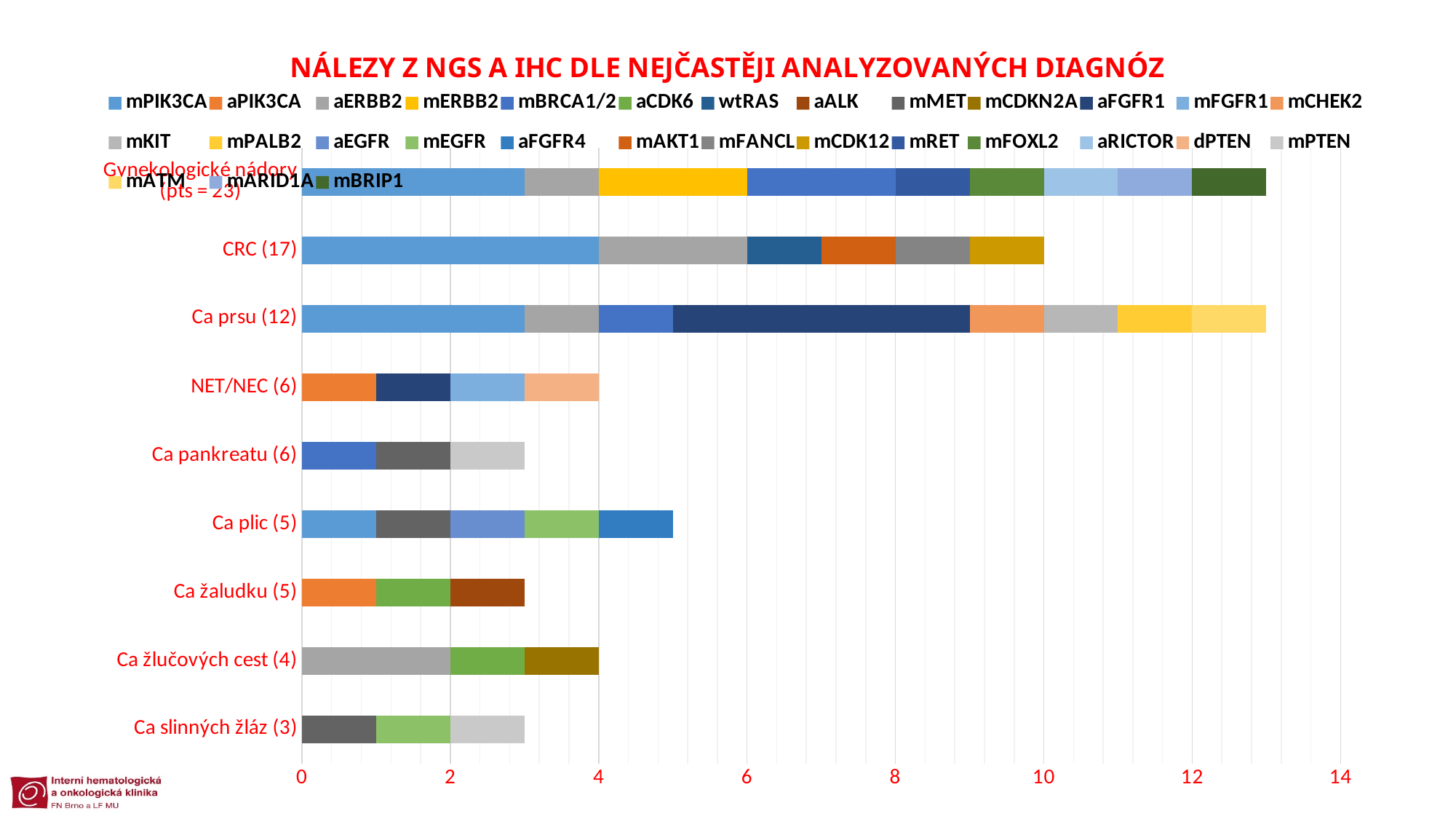
Is the total bar length for Ca plic (5) greater or less than 4? greater What is the title of the chart? NÁLEZY Z NGS A IHC DLE NEJČASTĚJI ANALYZOVANÝCH DIAGNÓZ What is the total length of the stacked bar for CRC (17)? 10 How many diagnosis categories are plotted on the chart? 9 What is the total length of the stacked bar for NET/NEC (6)? 4 How many series does the legend list? 29 Is the total bar length for Gynekologické nádory (pts = 23) greater or less than 12? greater Which has the longer total bar, CRC (17) or Ca plic (5)? CRC (17) What kind of chart is shown on the slide? Stacked bar chart Is the total bar length for Ca pankreatu (6) greater or less than 4? less What is the total length of the stacked bar for Ca žlučových cest (4)? 4 What is the difference between the total bar length for CRC (17) and for NET/NEC (6)? 6